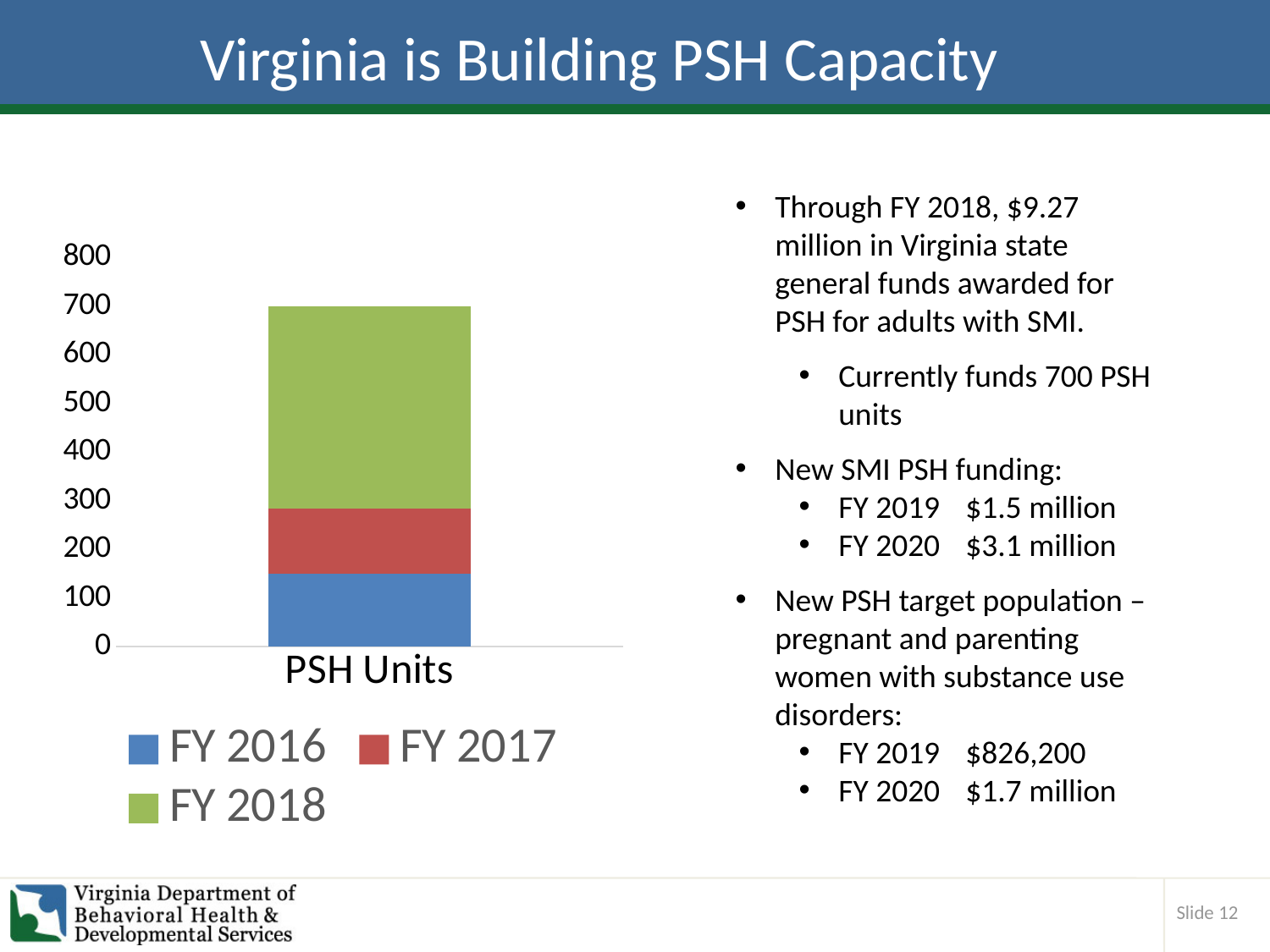
Which segment is larger in the PSH Units bar, FY 2018 or FY 2016? FY 2018 Which series contributes the largest segment to the PSH Units bar? FY 2018 Is the FY 2016 segment of the PSH Units bar greater or less than 200? less What kind of chart is shown on the slide? Stacked bar chart Which colour represents FY 2018 in the chart legend? Green How many series does the chart legend list? 3 How many categories are plotted on the x axis of the chart? 1 Is the FY 2017 segment of the PSH Units bar greater or less than 200? less What is the label of the single category on the chart's x axis? PSH Units Is the FY 2018 segment of the PSH Units bar greater or less than 300? greater What is the total height of the stacked PSH Units bar? 700